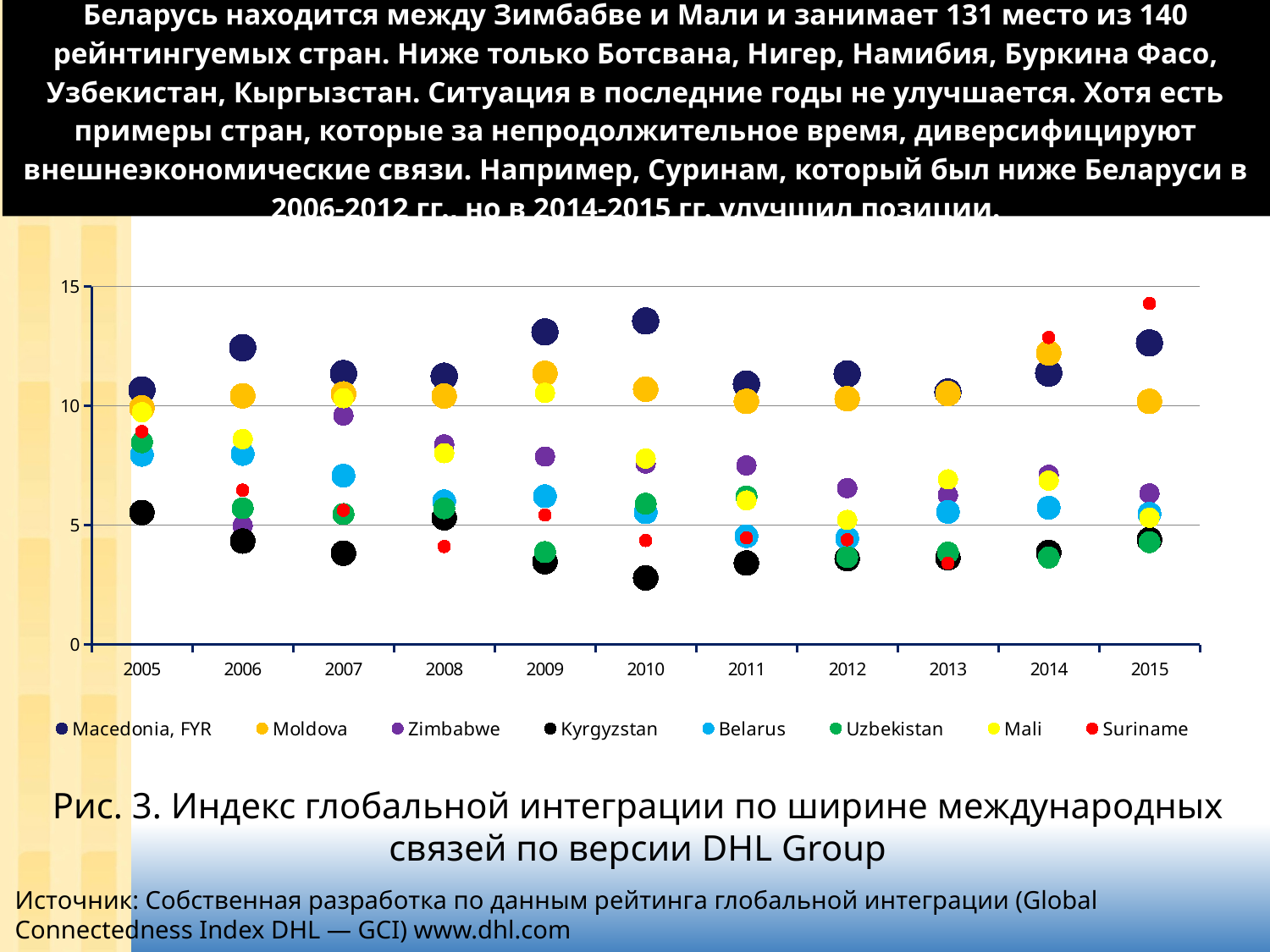
Which country has the highest value in 2010? Macedonia, FYR What kind of chart is shown on the slide? scatter chart How many series does the legend list? 8 How many years are shown on the x axis? 11 Does the value for Suriname rise or fall from 2013 to 2015? rise Is the value for Belarus in 2015 greater or less than 10? less Which is larger in 2015, the value for Suriname or the value for Belarus? Suriname Which country is shown in red in the legend? Suriname Which country has the highest value in 2015? Suriname Is the value for Kyrgyzstan in 2010 greater or less than 5? less Which country has the lowest value in 2010? Kyrgyzstan Is the value for Macedonia, FYR in 2010 greater or less than 10? greater